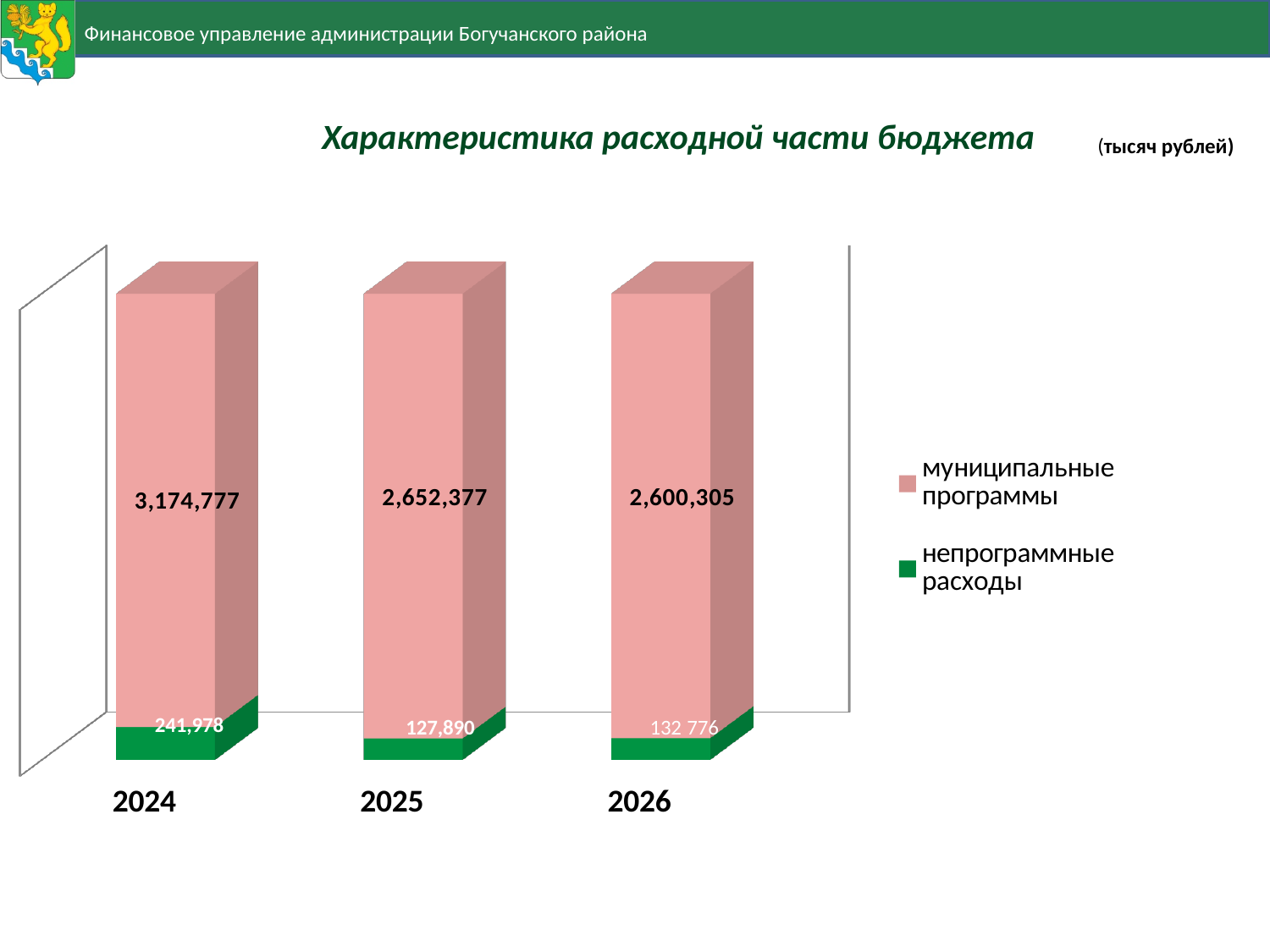
What is the value for непрограммные расходы in 2025? 127,890 What kind of chart is shown on the slide? Stacked bar chart What is the value for муниципальные программы in 2024? 3,174,777 In which year is the value for муниципальные программы the highest? 2024 How many series does the legend list? 2 What is the difference between the муниципальные программы values for 2024 and 2025? 522,400 In which year is the value for непрограммные расходы the lowest? 2025 How many years are shown on the x axis? 3 What is the total of the stacked bar for 2025? 2,780,267 What is the value for муниципальные программы in 2026? 2,600,305 What is the value for непрограммные расходы in 2026? 132 776 Which is larger: непрограммные расходы in 2024 or in 2026? 2024